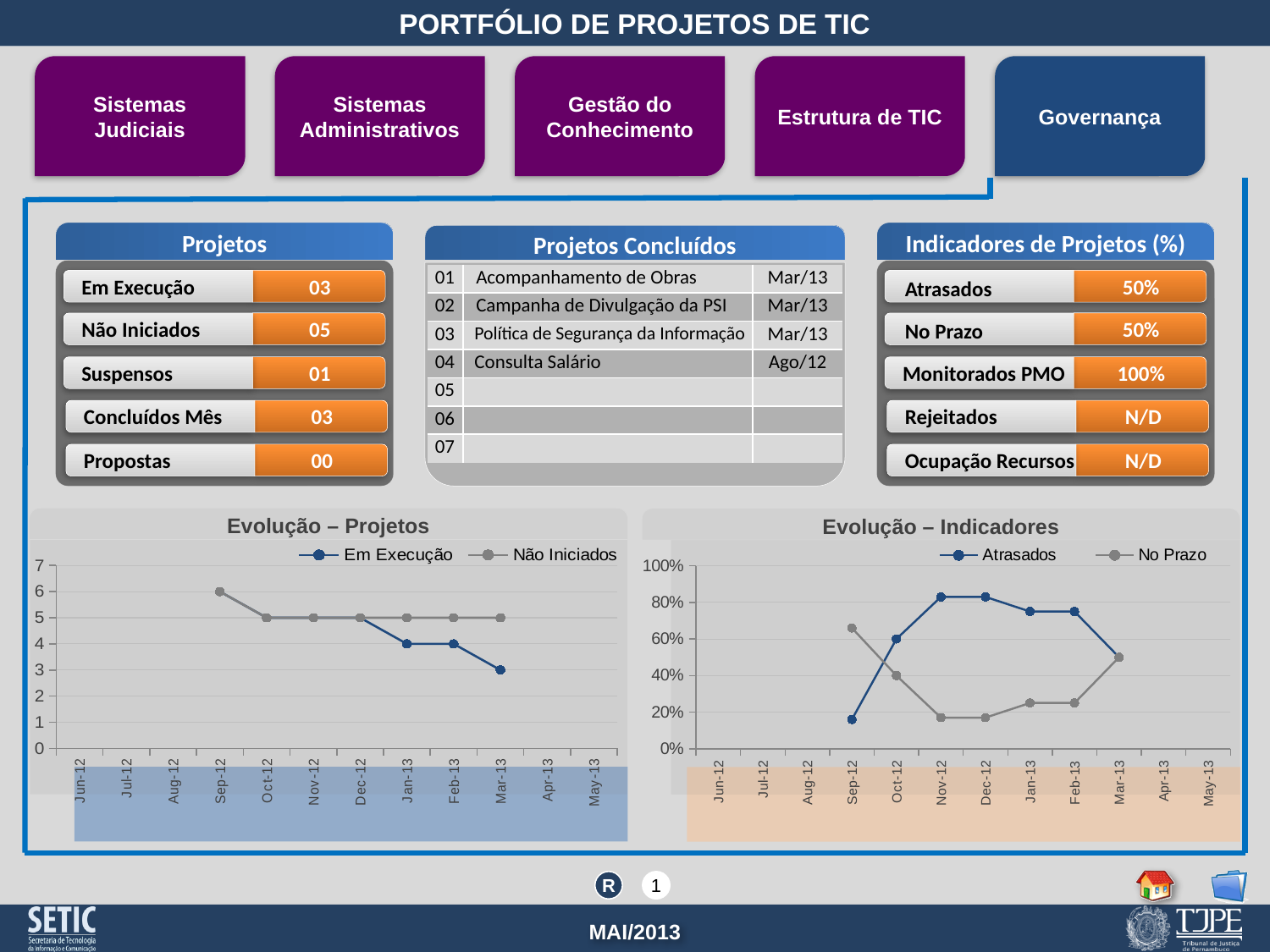
In the "Evolução – Indicadores" chart, what is the value of Atrasados at Oct-12? 60% How many series does the legend of the "Evolução – Projetos" chart list? 2 In the "Evolução – Projetos" chart, what is the value of Em Execução at Mar-13? 3 In the "Evolução – Indicadores" chart, which series is higher at Sep-12, Atrasados or No Prazo? No Prazo What kind of chart is the "Evolução – Projetos" chart? line chart In the "Evolução – Projetos" chart, does the Em Execução series rise or fall from Dec-12 to Mar-13? fall In the "Evolução – Projetos" chart, which series is higher at Mar-13, Em Execução or Não Iniciados? Não Iniciados Which series does the legend of the "Evolução – Indicadores" chart list besides Atrasados? No Prazo What kind of chart is the "Evolução – Indicadores" chart? line chart In the "Evolução – Projetos" chart, what is the value of Não Iniciados at Sep-12? 6 In the "Evolução – Projetos" chart, what is the difference between Não Iniciados and Em Execução at Jan-13? 1